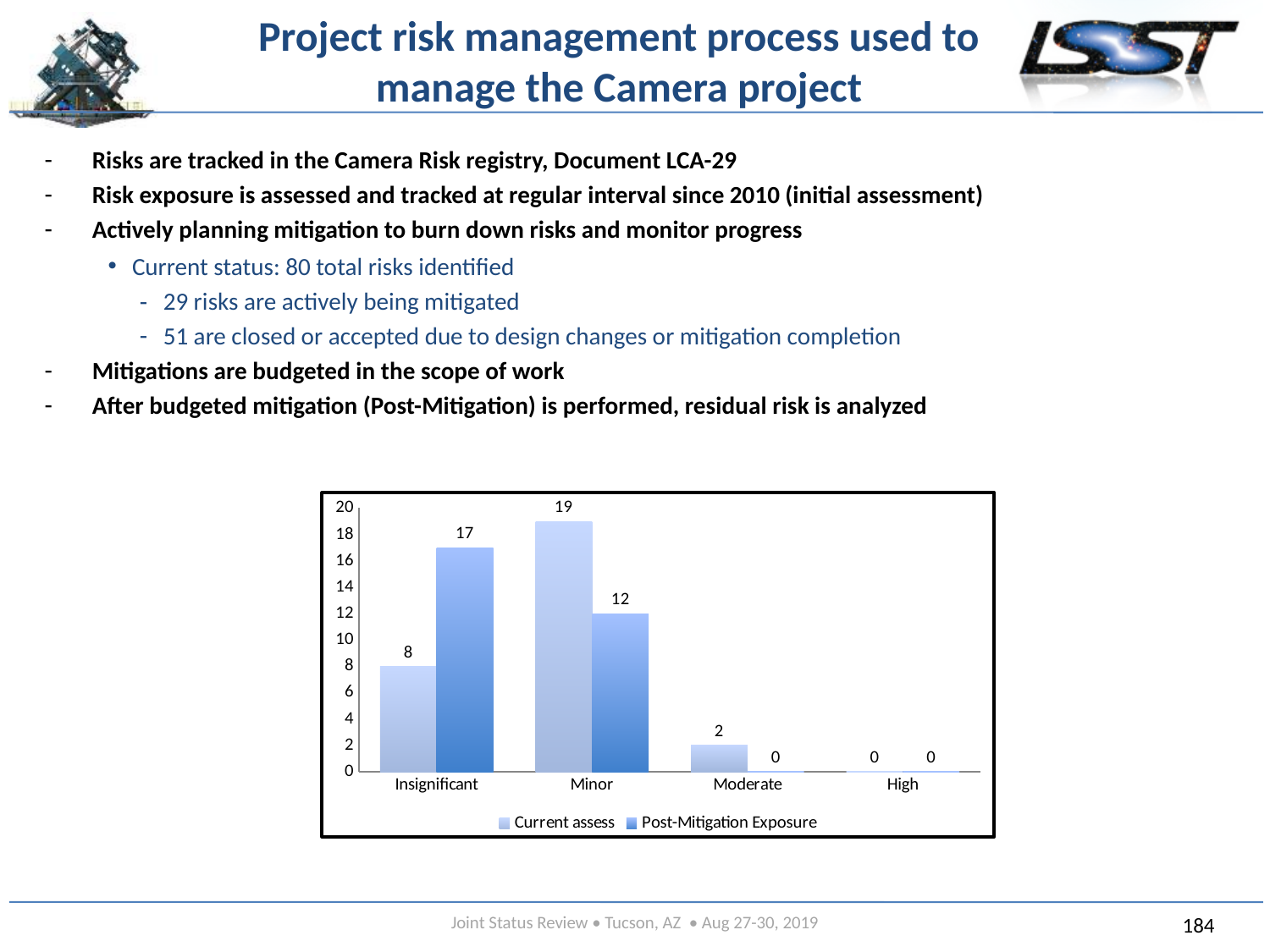
Which category has the highest Current assess value? Minor What is the Current assess value for the Moderate category? 2 What is the Current assess value for the Minor category? 19 What is the difference between the Post-Mitigation Exposure and Current assess values for the Insignificant category? 9 How many categories are shown on the x axis of the chart? 4 What is the Post-Mitigation Exposure value for the Insignificant category? 17 What are the two series named in the chart legend? Current assess and Post-Mitigation Exposure Which is larger for the Insignificant category: Current assess or Post-Mitigation Exposure? Post-Mitigation Exposure Which category has the highest Post-Mitigation Exposure value? Insignificant What kind of chart is shown on the slide? Bar chart What is the difference between the Current assess and Post-Mitigation Exposure values for the Minor category? 7 How many series does the chart legend list? 2